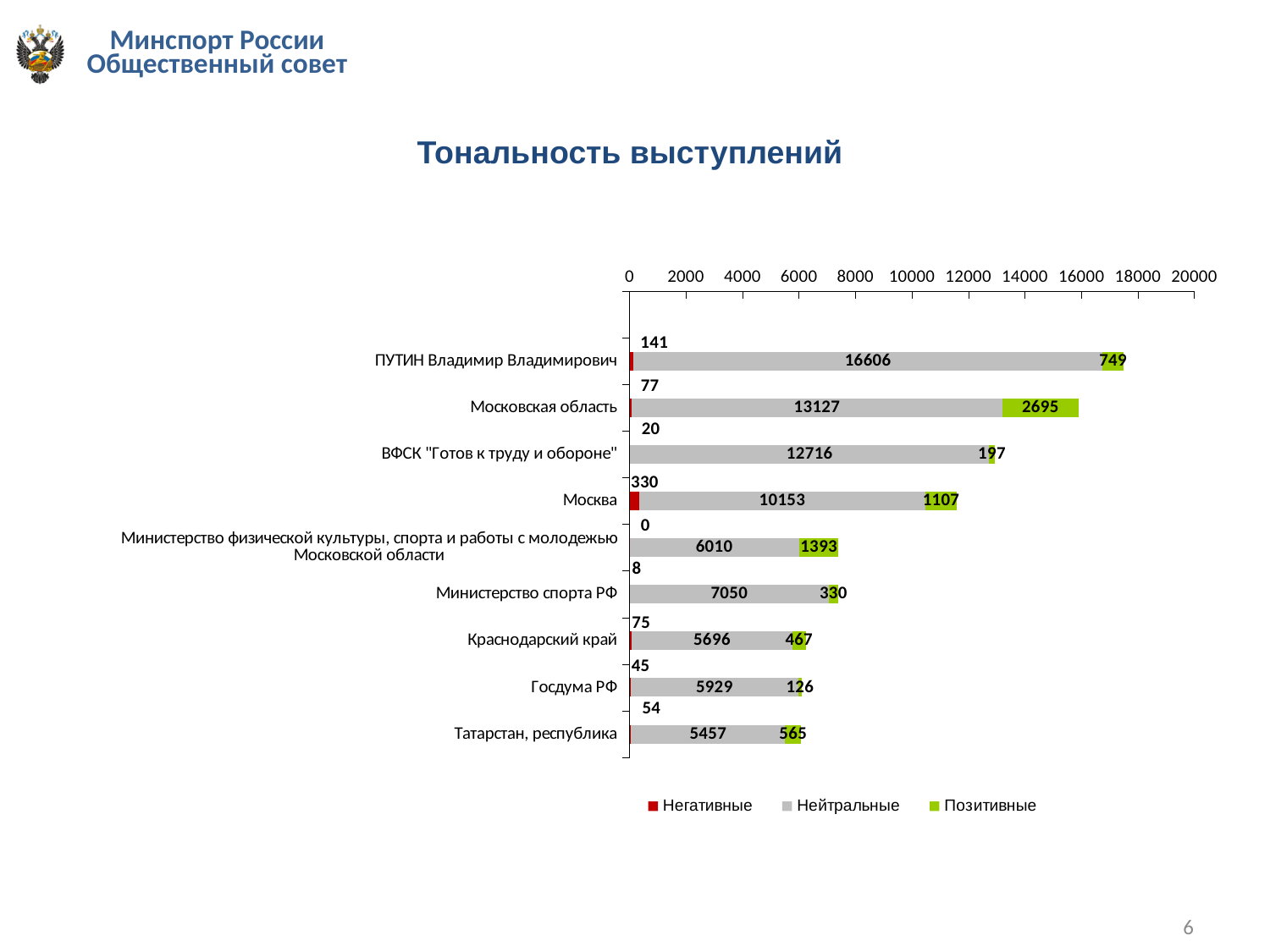
What is the Позитивные value for Московская область? 2695 How many series does the legend list? 3 How many categories are plotted on the chart? 9 What is the title of the chart? Тональность выступлений What kind of chart is shown on the slide? Stacked bar chart Which category has the lowest Негативные value? Министерство физической культуры, спорта и работы с молодежью Московской области What is the difference between the Нейтральные values for Московская область and ВФСК "Готов к труду и обороне"? 411 Which is larger, the Позитивные value for Москва or for Министерство физической культуры, спорта и работы с молодежью Московской области? Министерство физической культуры, спорта и работы с молодежью Московской области Which category has the highest Нейтральные value? ПУТИН Владимир Владимирович What is the Негативные value for Москва? 330 What is the Нейтральные value for ПУТИН Владимир Владимирович? 16606 What is the total of the stacked bar for Москва? 11590